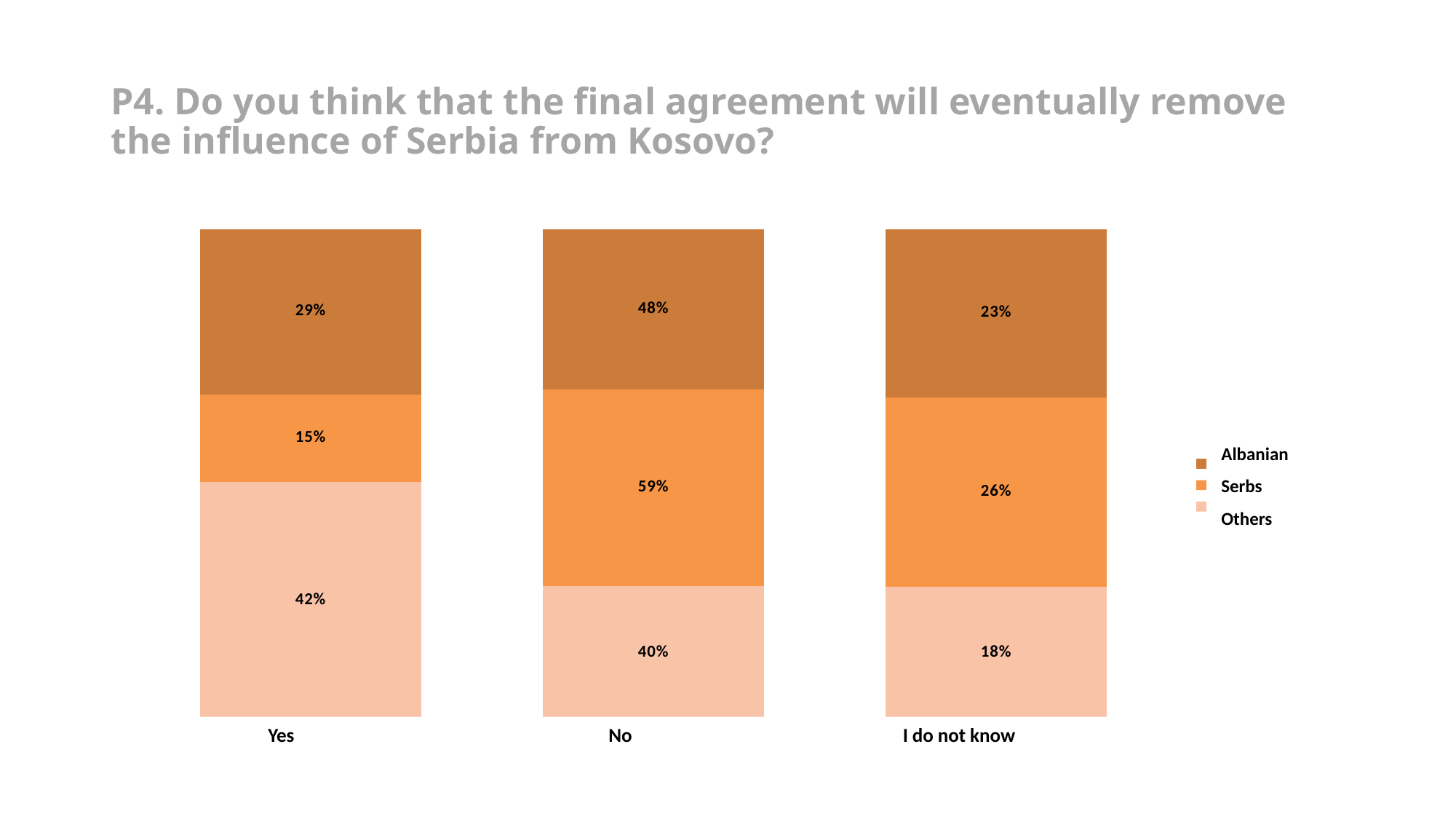
What is the difference between the Serbs and Albanian values for "No"? 11% For which answer category is the Albanian value highest? No For which answer category is the Serbs value lowest? Yes What percentage of Serbs answered "No"? 59% What kind of chart is shown on the slide? Stacked bar chart How many series does the legend list? 3 How many answer categories are shown on the x axis? 3 Which is larger for "Yes": the Albanian value or the Others value? Others What percentage of Albanian respondents answered "Yes"? 29% What percentage of Serbs answered "Yes"? 15% What percentage of Others answered "I do not know"? 18% For which answer category is the Others value highest? Yes